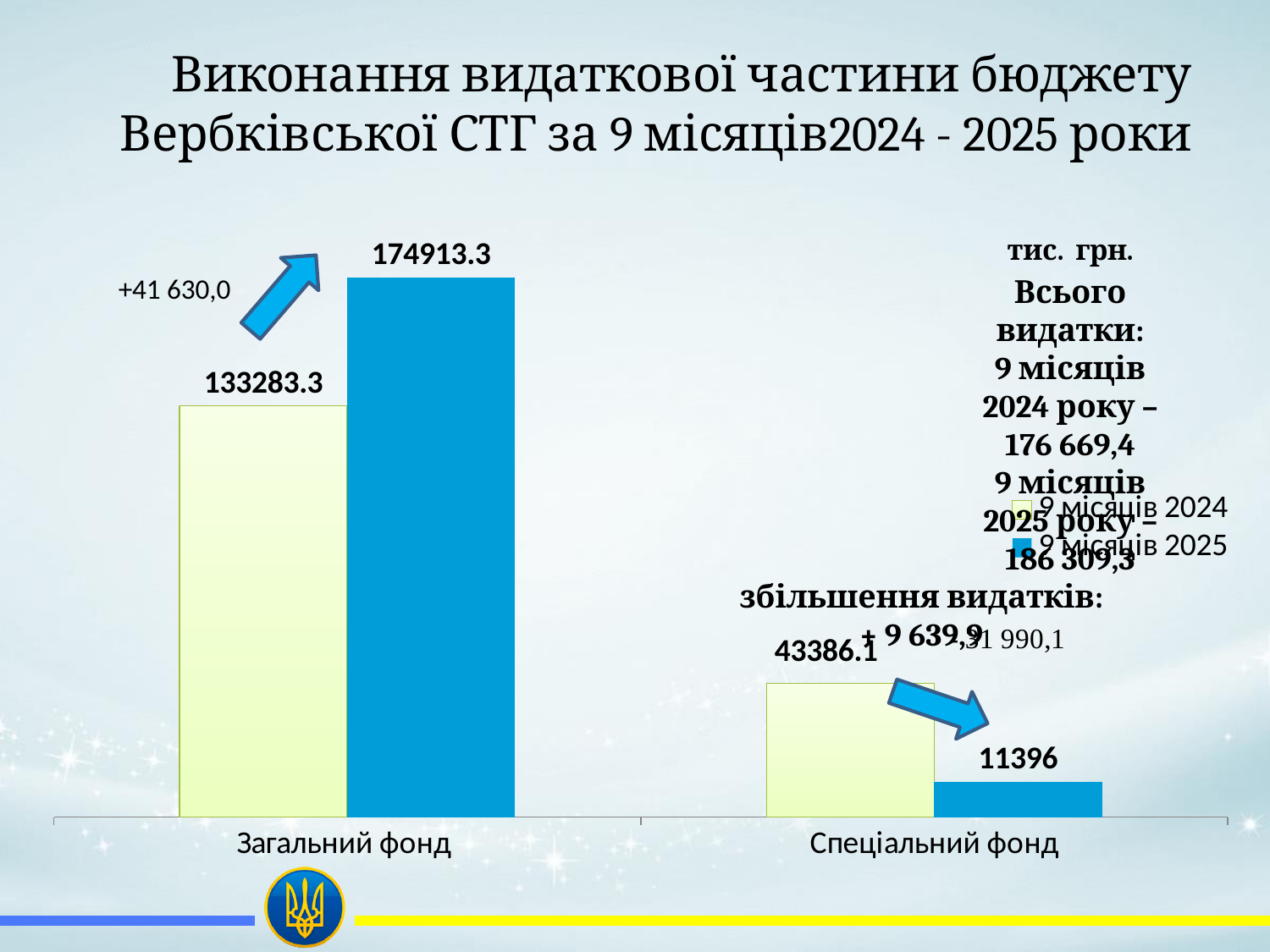
What kind of chart is shown on the slide? Bar chart What is the value for Загальний фонд in the 9 місяців 2024 series? 133283.3 How many categories are shown on the x axis? 2 What is the value for Загальний фонд in the 9 місяців 2025 series? 174913.3 How many series does the legend list? 2 Which bar has the highest value on the chart? Загальний фонд, 9 місяців 2025 What is the value for Спеціальний фонд in the 9 місяців 2024 series? 43386.1 What is the difference between the 9 місяців 2025 and 9 місяців 2024 values for Загальний фонд? 41630 For Спеціальний фонд, which series has the larger value: 9 місяців 2024 or 9 місяців 2025? 9 місяців 2024 Which bar has the lowest value on the chart? Спеціальний фонд, 9 місяців 2025 What is the value for Спеціальний фонд in the 9 місяців 2025 series? 11396 What is the difference between the 9 місяців 2024 and 9 місяців 2025 values for Спеціальний фонд? 31990.1